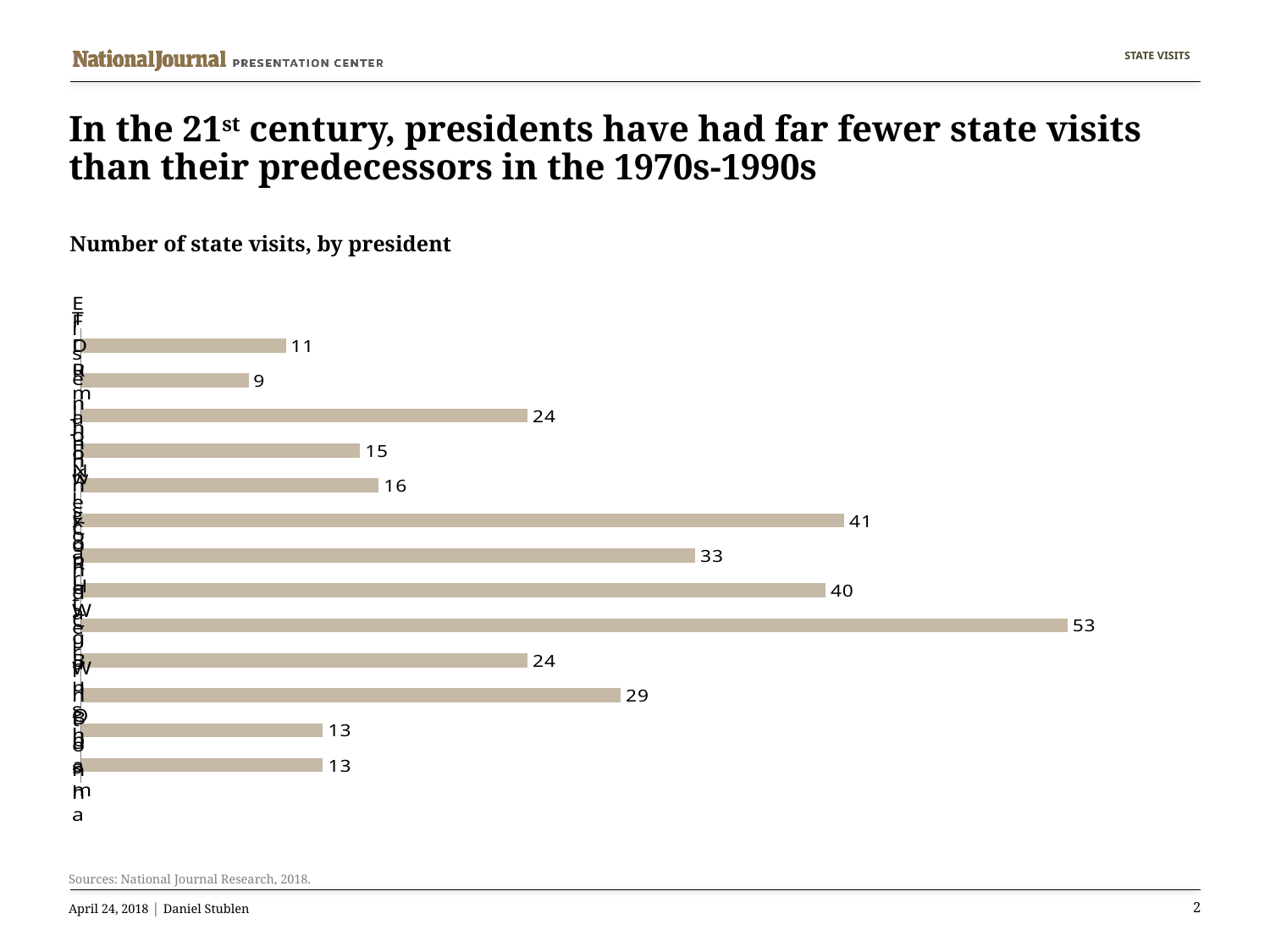
How many bars are plotted in the chart? 13 What value is labelled on the bottom bar of the chart? 13 How many bars in the chart have a value of 24? 2 What kind of chart is shown on the slide? bar chart What is the lowest number of state visits shown in the chart? 9 What value is labelled on the second bar from the top? 9 How many bars in the chart have a value greater than 30? 4 What is the difference between the highest and lowest values in the chart? 44 What is the highest number of state visits shown in the chart? 53 What value is labelled on the topmost bar of the chart? 11 What source is cited for the chart data? National Journal Research, 2018 What is the subtitle describing what the chart measures? Number of state visits, by president